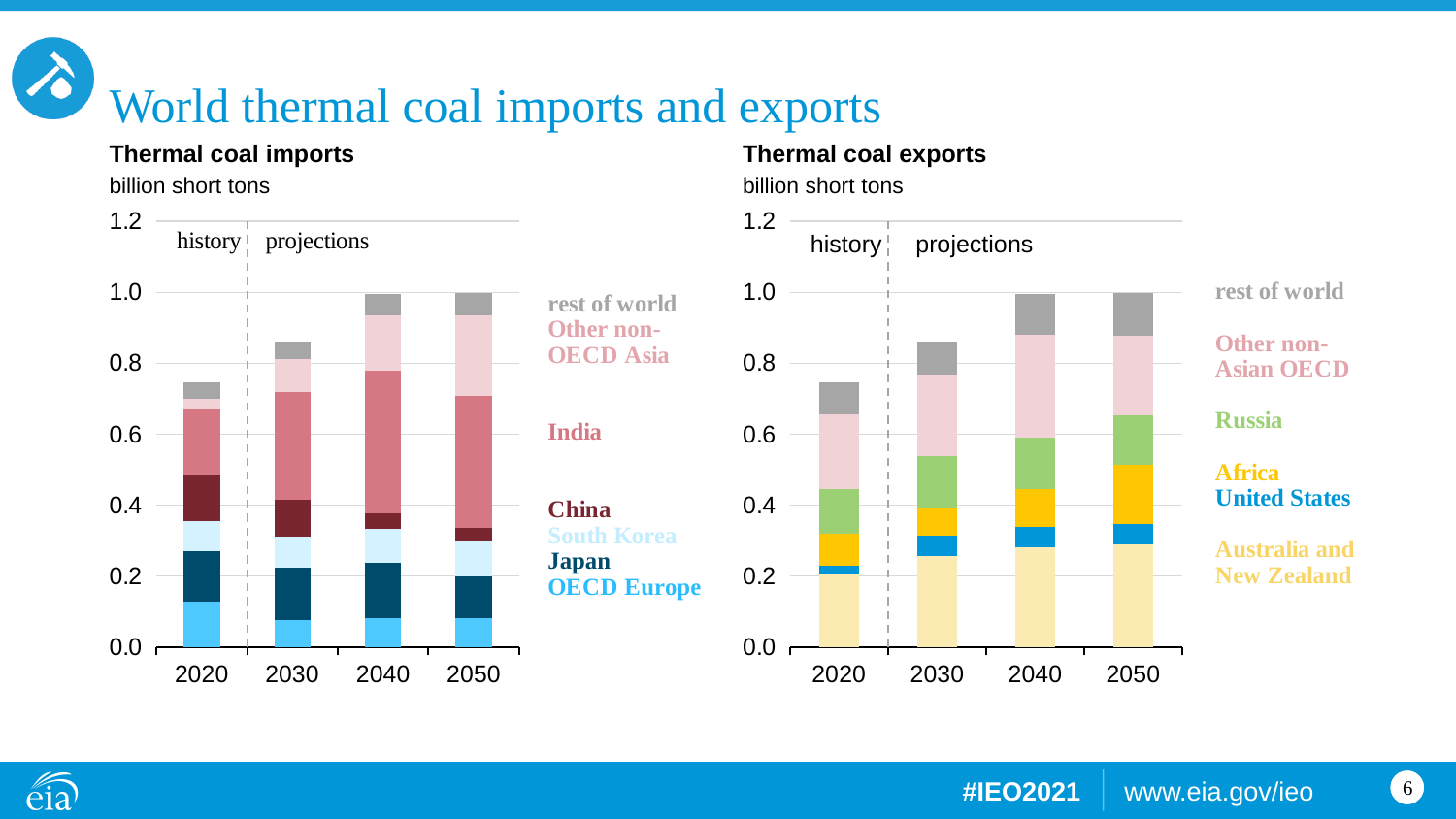
In the Thermal coal exports chart, which series is shown at the bottom of each stacked bar? Australia and New Zealand In the Thermal coal imports chart, how many series does the legend list? 7 In the Thermal coal exports chart, how many years are shown on the x axis? 4 What unit is used on the y axis of the Thermal coal exports chart? billion short tons In the Thermal coal imports chart, what kind of chart is shown? stacked bar chart In the Thermal coal imports chart, which year has the lowest total? 2020 In the Thermal coal exports chart, how many series does the legend list? 6 In the Thermal coal exports chart, which total is larger, 2020 or 2050? 2050 In the Thermal coal imports chart, do the totals rise or fall from 2020 to 2050? rise In the Thermal coal imports chart, is the total for 2020 greater or less than 0.8? less In the Thermal coal exports chart, is the total for 2030 greater or less than 0.8? greater In the Thermal coal exports chart, is the total for 2020 greater or less than 0.6? greater